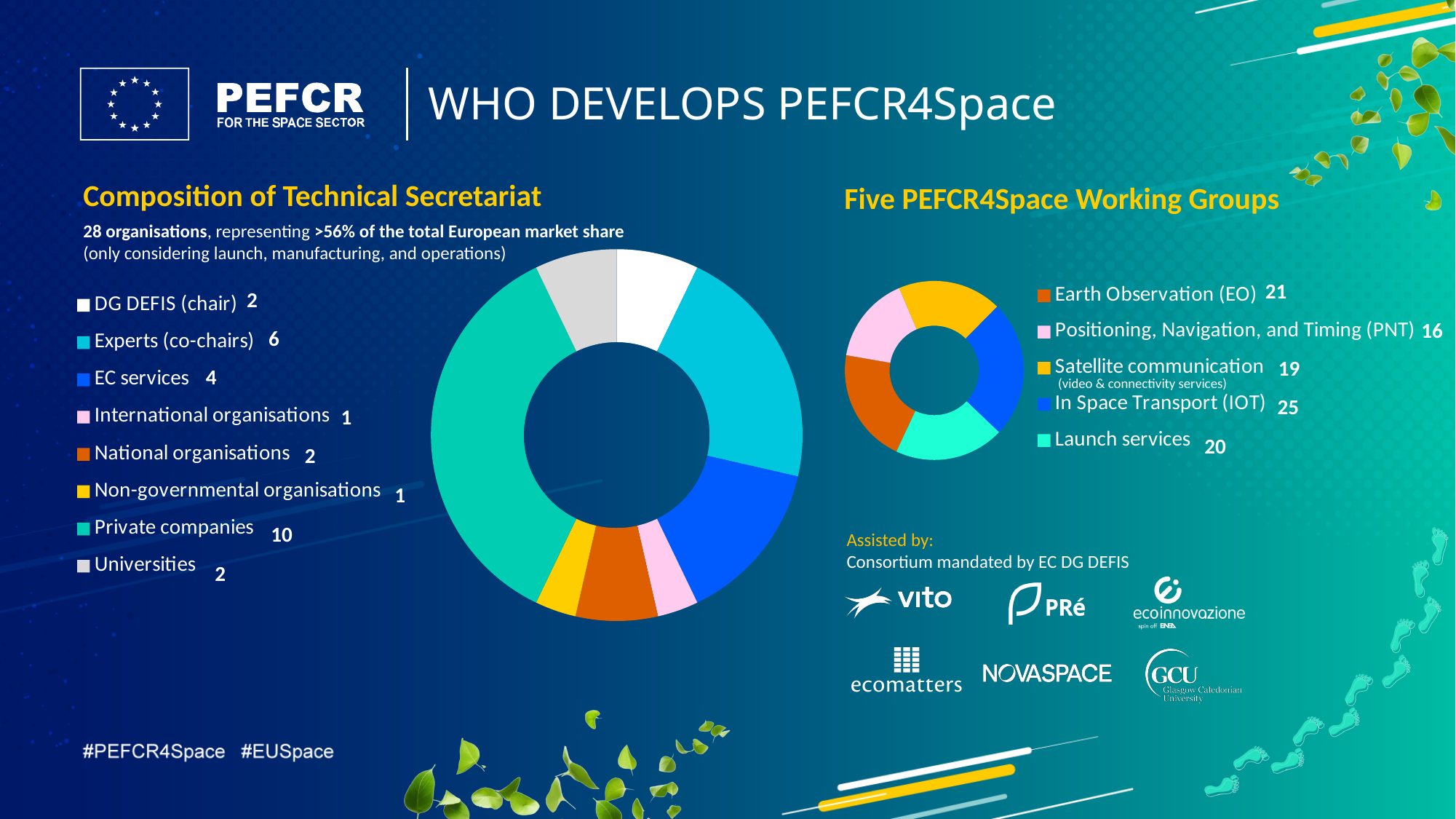
In the Five PEFCR4Space Working Groups chart, which working group has the smallest value? Positioning, Navigation, and Timing (PNT) In the Composition of Technical Secretariat chart, what is the difference between Private companies and EC services? 6 In the Composition of Technical Secretariat chart, how many private companies are there? 10 In the Five PEFCR4Space Working Groups chart, what is the value for In Space Transport (IOT)? 25 In the Five PEFCR4Space Working Groups chart, what colour represents Launch services? Turquoise (light green) What kind of chart is used for the Composition of Technical Secretariat? Donut (pie) chart In the Five PEFCR4Space Working Groups chart, what is the total of all five working group values? 101 In the Composition of Technical Secretariat chart, what is the value for Experts (co-chairs)? 6 In the Composition of Technical Secretariat chart, which is larger: Experts (co-chairs) or EC services? Experts (co-chairs) In the Composition of Technical Secretariat chart, how many categories are shown in the legend? 8 In the Composition of Technical Secretariat chart, which category has the largest value? Private companies In the Five PEFCR4Space Working Groups chart, what is the difference between In Space Transport (IOT) and Earth Observation (EO)? 4